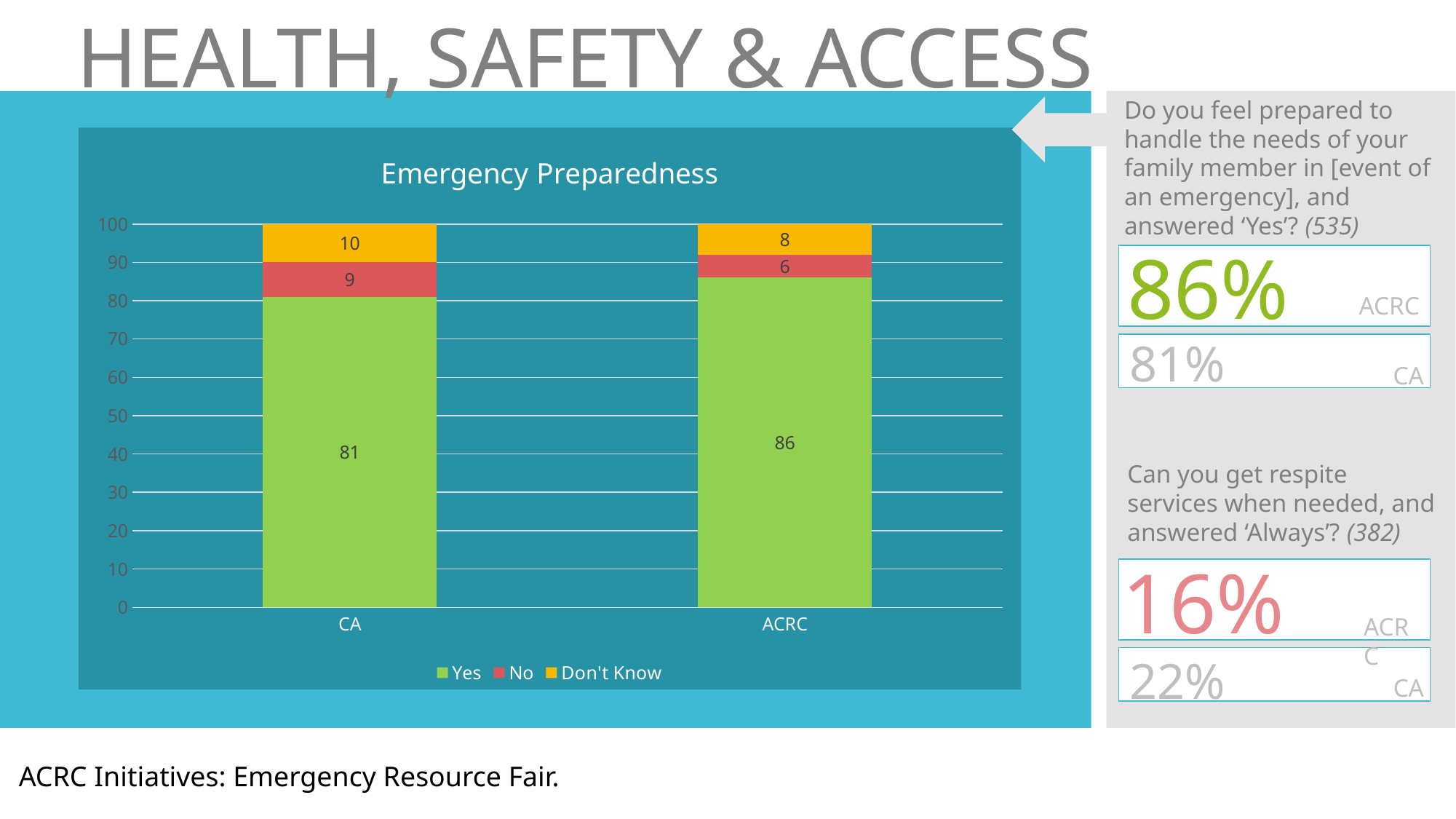
Which series is shown in green in the legend? Yes What is the title of the chart? Emergency Preparedness What is the difference between the 'Yes' values for ACRC and CA? 5 How many categories are shown on the x axis? 2 What is the 'Yes' value for CA? 81 How many series does the legend list? 3 What is the 'Yes' value for ACRC? 86 What is the 'Don't Know' value for CA? 10 What is the total of the stacked bar for ACRC? 100 What is the 'No' value for ACRC? 6 Which category has the higher 'Yes' value? ACRC What type of chart is shown? Stacked bar chart